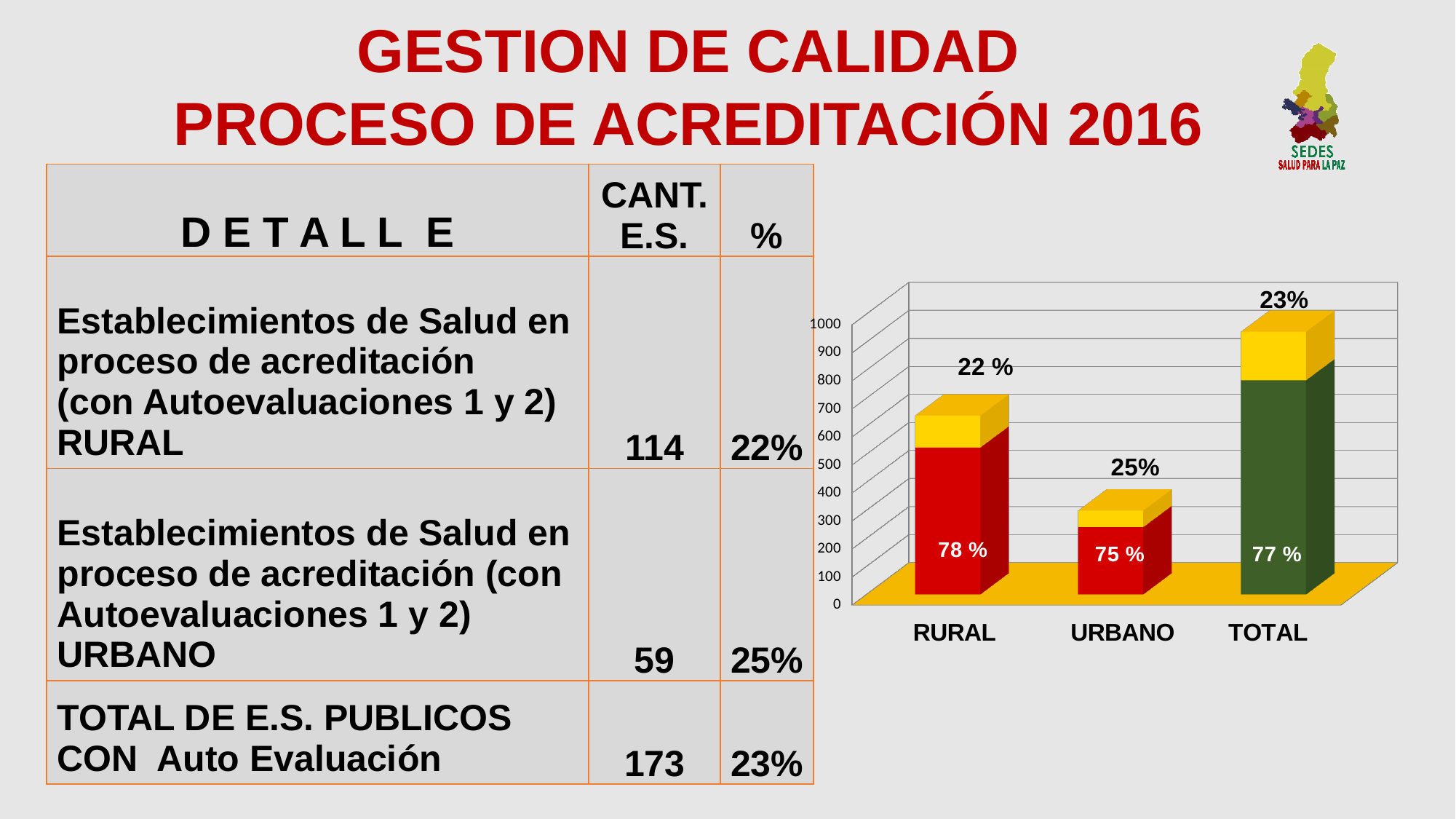
What percentage label is shown on the lower (green) segment of the TOTAL bar? 77 % How many categories are shown on the x axis of the chart? 3 What kind of chart is shown on the slide? bar chart What percentage label is shown on the top (yellow) segment of the TOTAL bar? 23% What percentage label is shown on the top (yellow) segment of the URBANO bar? 25% Which category has the shortest bar in the chart? URBANO Which category has the tallest bar in the chart? TOTAL What percentage label is shown on the top (yellow) segment of the RURAL bar? 22 % Is the total height of the URBANO bar greater or less than 500? less Is the total height of the RURAL bar greater or less than 400? greater What percentage label is shown on the lower (red) segment of the URBANO bar? 75 % What percentage label is shown on the lower (red) segment of the RURAL bar? 78 %